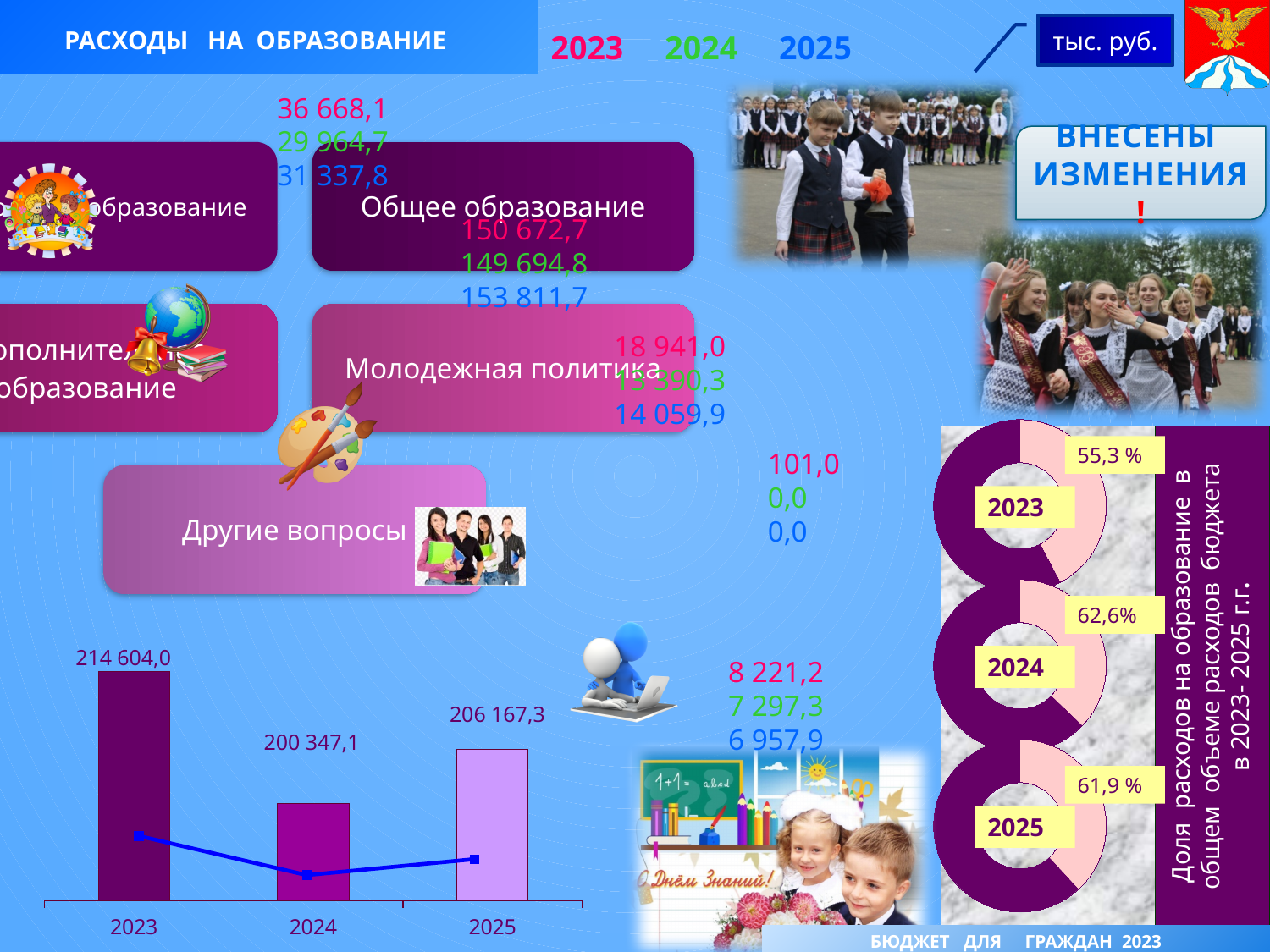
In the bar chart at the bottom left, what is the value for 2024? 200 347,1 What kind of chart is shown at the bottom left of the slide? bar chart In the bar chart at the bottom left, which year has the lowest value? 2024 In the bar chart at the bottom left, what is the value for 2025? 206 167,3 In the bar chart at the bottom left, what is the difference between the values for 2023 and 2025? 8 436,7 In the bar chart at the bottom left, do the values rise or fall from 2023 to 2024? fall How many bars are shown in the bar chart at the bottom left? 3 In the bar chart at the bottom left, what is the value for 2023? 214 604,0 In the bar chart at the bottom left, what is the difference between the values for 2023 and 2024? 14 256,9 In the bar chart at the bottom left, which is larger: the value for 2023 or the value for 2025? 2023 In the bar chart at the bottom left, what is the difference between the values for 2025 and 2024? 5 820,2 In the bar chart at the bottom left, which year has the highest value? 2023